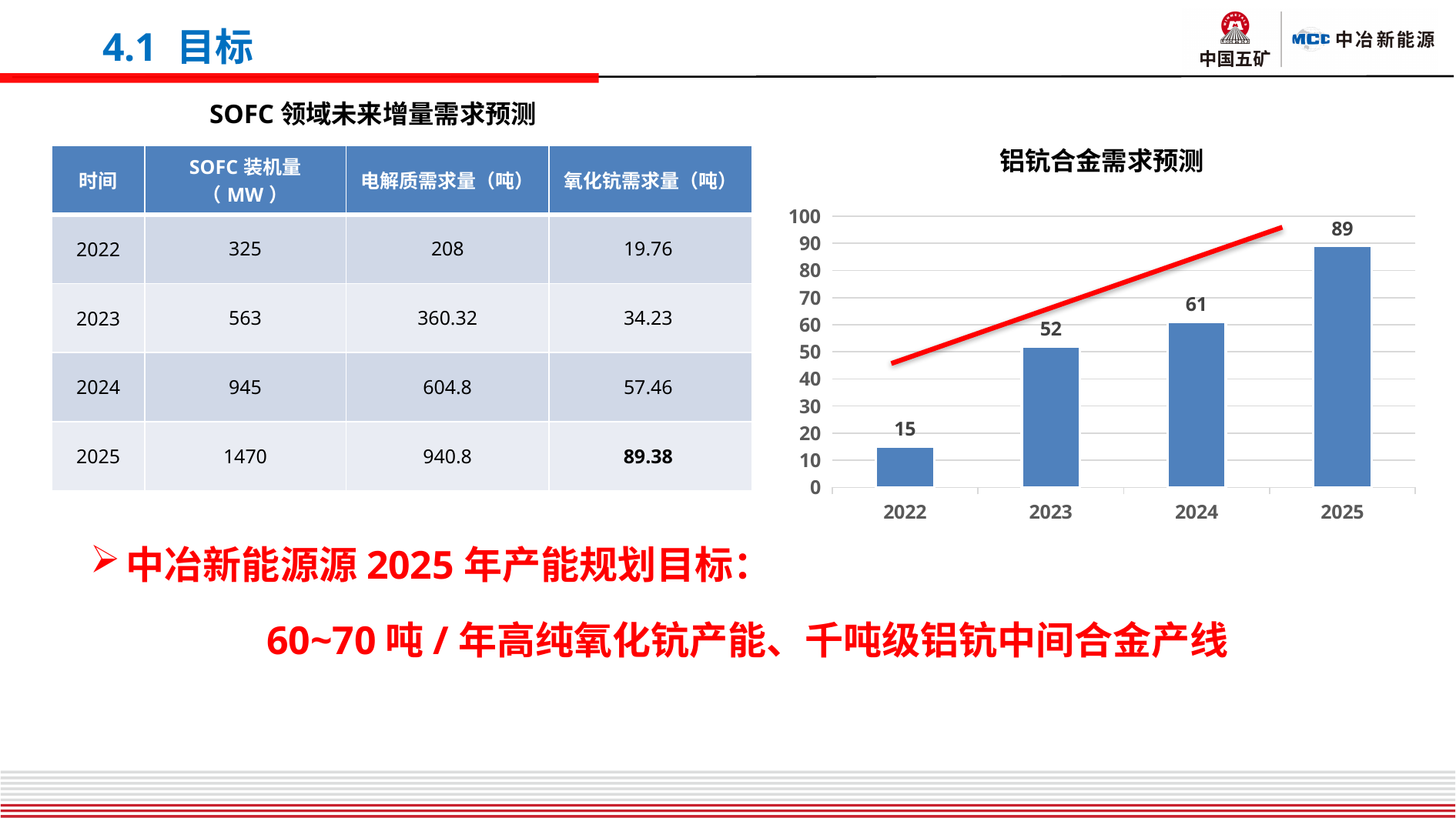
What is the difference between the 2024 and 2023 values in the 铝钪合金需求预测 chart? 9 Which year has the highest value in the 铝钪合金需求预测 chart? 2025 How many years are shown on the x axis of the 铝钪合金需求预测 chart? 4 What is the difference between the 2025 and 2022 values in the 铝钪合金需求预测 chart? 74 Do the values in the 铝钪合金需求预测 chart rise or fall from 2022 to 2025? Rise What kind of chart is the 铝钪合金需求预测 chart? Bar chart Which year has the lowest value in the 铝钪合金需求预测 chart? 2022 What is the value for 2024 in the 铝钪合金需求预测 chart? 61 What is the value for 2022 in the 铝钪合金需求预测 chart? 15 What is the value for 2025 in the 铝钪合金需求预测 chart? 89 In the 铝钪合金需求预测 chart, which is larger, the value for 2023 or the value for 2024? 2024 What is the value for 2023 in the 铝钪合金需求预测 chart? 52